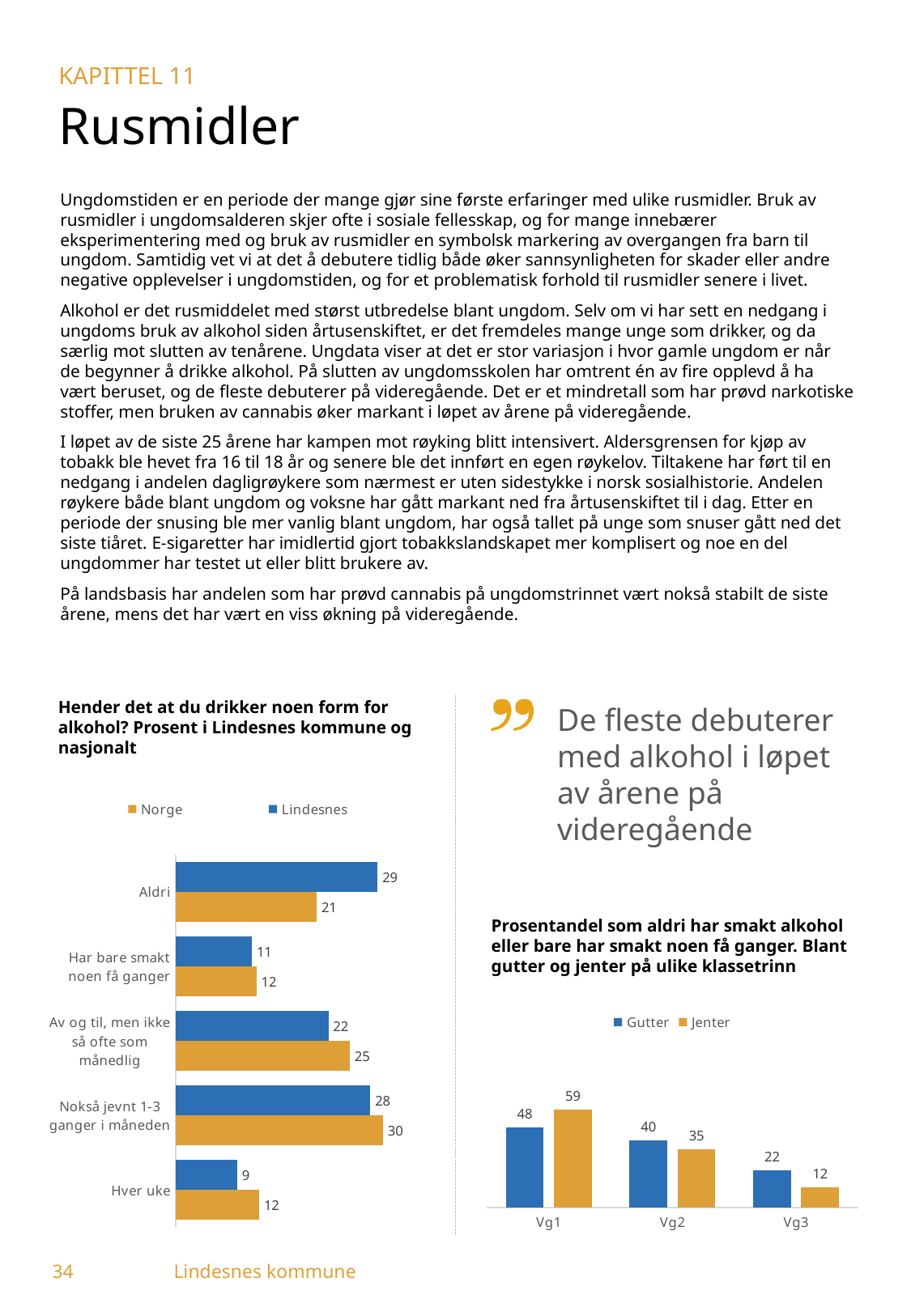
In the chart 'Hender det at du drikker noen form for alkohol?', which category has the lowest value for Lindesnes? Hver uke In the chart 'Hender det at du drikker noen form for alkohol?', what is the value for Lindesnes in the category 'Aldri'? 29 In the chart 'Prosentandel som aldri har smakt alkohol eller bare har smakt noen få ganger', do the values for Jenter rise or fall from Vg1 to Vg3? Fall How many series does the legend list in the chart 'Prosentandel som aldri har smakt alkohol eller bare har smakt noen få ganger'? 2 In the chart 'Hender det at du drikker noen form for alkohol?', what is the value for Norge in the category 'Hver uke'? 12 What type of chart is 'Hender det at du drikker noen form for alkohol?'? Bar chart How many categories are shown in the chart 'Hender det at du drikker noen form for alkohol?'? 5 In the chart 'Hender det at du drikker noen form for alkohol?', what is the difference between the Norge and Lindesnes values for 'Aldri'? 8 In the chart 'Prosentandel som aldri har smakt alkohol eller bare har smakt noen få ganger', what is the value for Gutter in Vg3? 22 In the chart 'Hender det at du drikker noen form for alkohol?', which is larger for 'Nokså jevnt 1-3 ganger i måneden': Norge or Lindesnes? Norge In the chart 'Prosentandel som aldri har smakt alkohol eller bare har smakt noen få ganger', what is the value for Jenter in Vg1? 59 In the chart 'Prosentandel som aldri har smakt alkohol eller bare har smakt noen få ganger', what is the difference between Gutter and Jenter in Vg2? 5